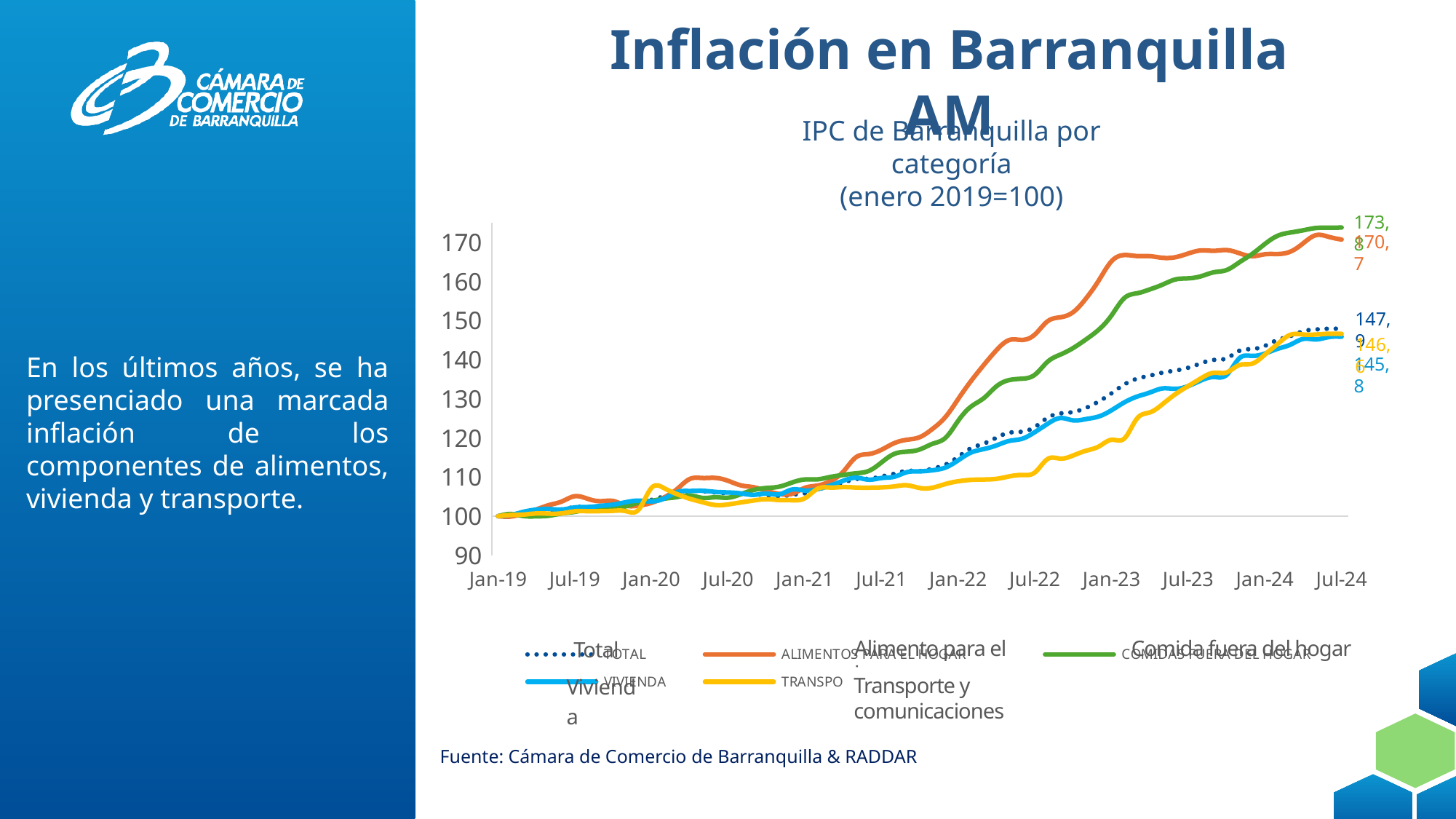
Which series has the highest value at the end of the chart (Jul-24)? Comida fuera del hogar What is the difference between the final values of Comida fuera del hogar (173,8) and Alimentos para el hogar (170,7)? 3,1 What is the final value (Jul-24) of the Comida fuera del hogar series? 173,8 What is the final value (Jul-24) of the Total series? 147,9 Is the value of the Alimentos para el hogar series at Jan-23 greater or less than 160? greater How many series does the chart's legend list? 5 What is the final value (Jul-24) of the Alimentos para el hogar series? 170,7 At Jul-24, which is larger: the Total series or the Transporte y comunicaciones series? Total What base period is the index set to 100, according to the chart title? enero 2019 Does the Total series rise or fall from Jan-19 to Jul-24? rise What kind of chart is shown on the slide? line chart Which series has the lowest value at the end of the chart (Jul-24)? Vivienda